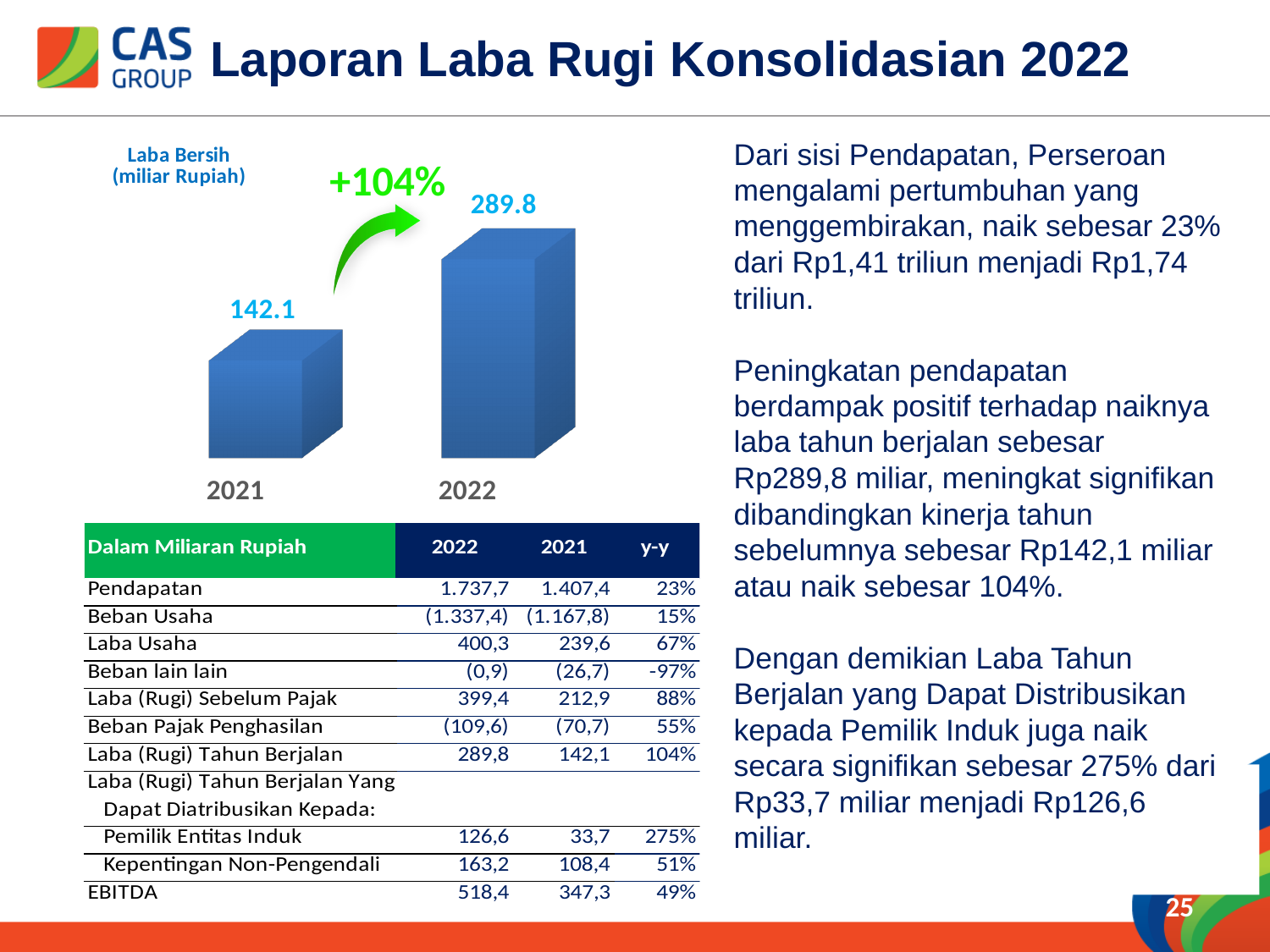
What percentage change is annotated between the two bars in the Laba Bersih chart? +104% Which year has the lower value in the Laba Bersih chart? 2021 What is the value for 2022 in the Laba Bersih chart? 289.8 Is the value for 2022 larger or smaller than the value for 2021 in the Laba Bersih chart? larger What is the value for 2021 in the Laba Bersih chart? 142.1 What is the difference between the 2022 and 2021 values in the Laba Bersih chart? 147.7 How many bars are shown in the Laba Bersih chart? 2 What unit is stated in the title of the Laba Bersih chart? miliar Rupiah Which year has the higher value in the Laba Bersih chart? 2022 Do the values in the Laba Bersih chart rise or fall from 2021 to 2022? rise What kind of chart is the Laba Bersih chart? bar chart